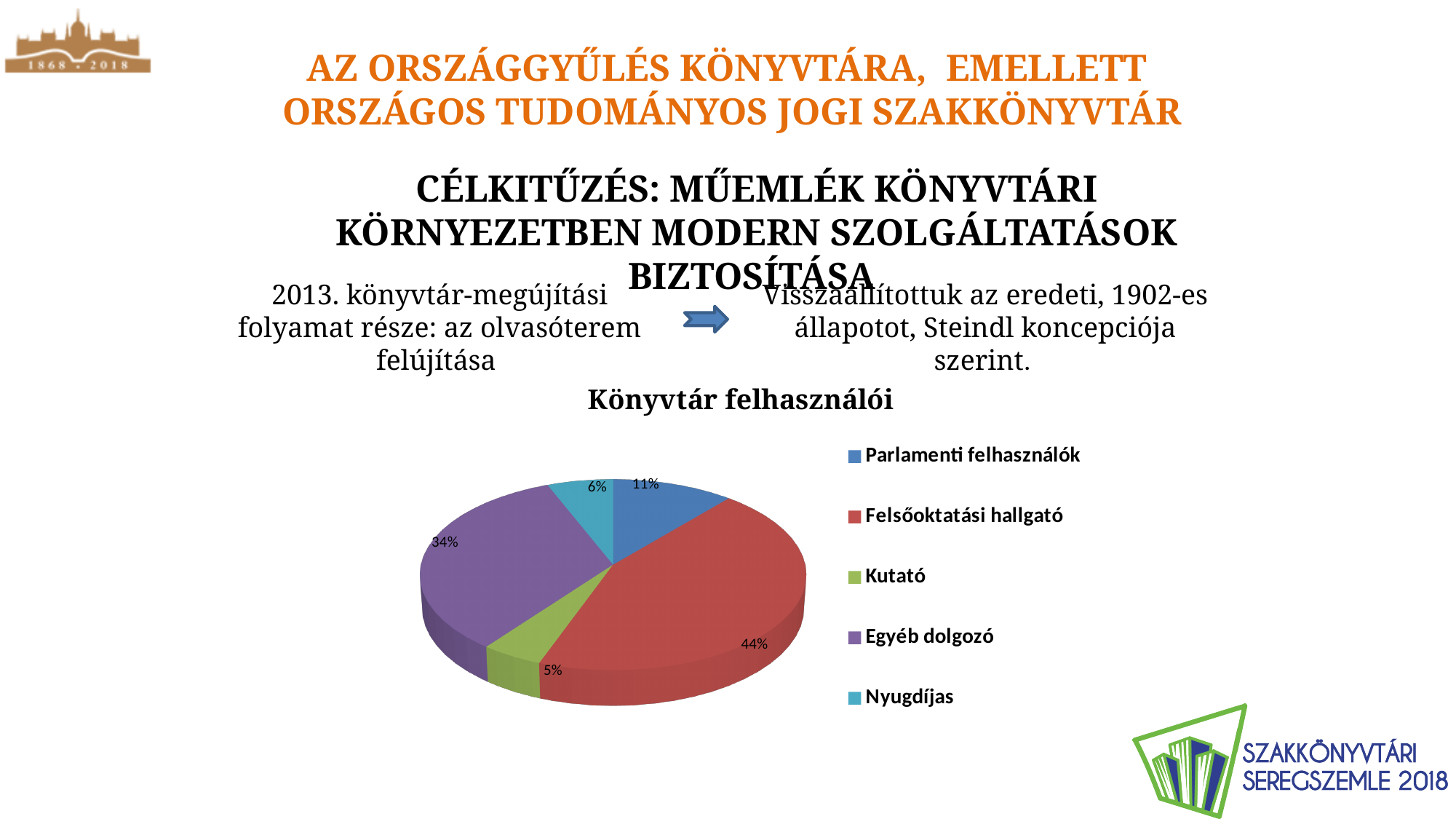
Which is larger, the share for Parlamenti felhasználók or the share for Nyugdíjas? Parlamenti felhasználók What share of the pie does Kutató have? 5% Which category has the largest slice of the pie? Felsőoktatási hallgató What share of the pie does Egyéb dolgozó have? 34% Which category has the smallest slice of the pie? Kutató What share of the pie does Felsőoktatási hallgató have? 44% What type of chart is shown on the slide? pie chart What is the title of the chart? Könyvtár felhasználói How many categories does the legend list? 5 What is the difference in percentage points between Felsőoktatási hallgató and Egyéb dolgozó? 10